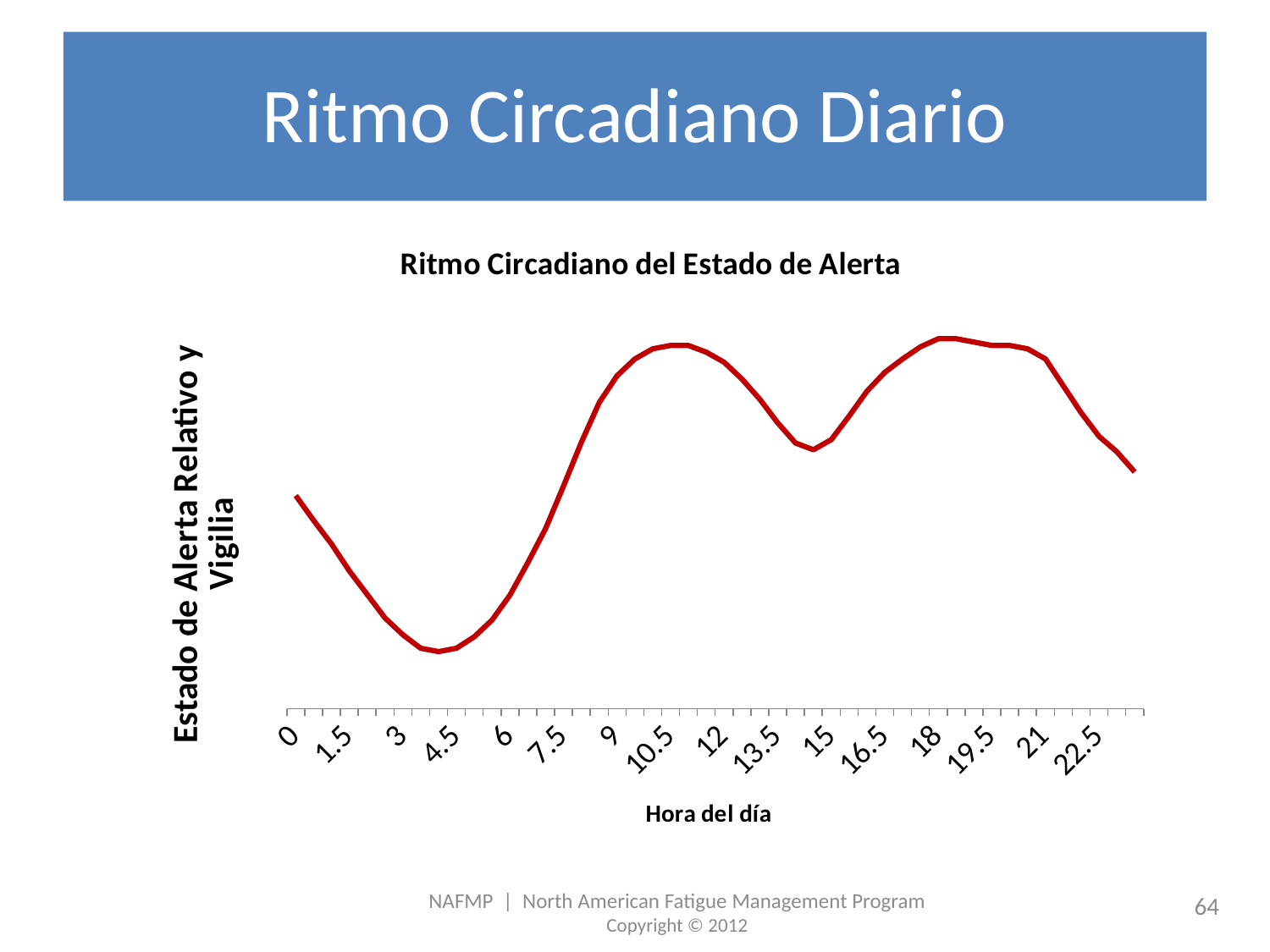
Does the line rise or fall between hour 21 and hour 22.5? fall Which is lower, the value at hour 4.5 or the value at hour 22.5? hour 4.5 What kind of chart is shown on the slide? line chart Does the line rise or fall between hour 4.5 and hour 10.5? rise What is the label of the x axis? Hora del día Which is higher, the value at hour 3 or the value at hour 9? hour 9 What is the title of the chart? Ritmo Circadiano del Estado de Alerta How many hour labels are shown on the x axis? 16 Does the line rise or fall between hour 0 and hour 4.5? fall Which is higher, the value at hour 0 or the value at hour 15? hour 15